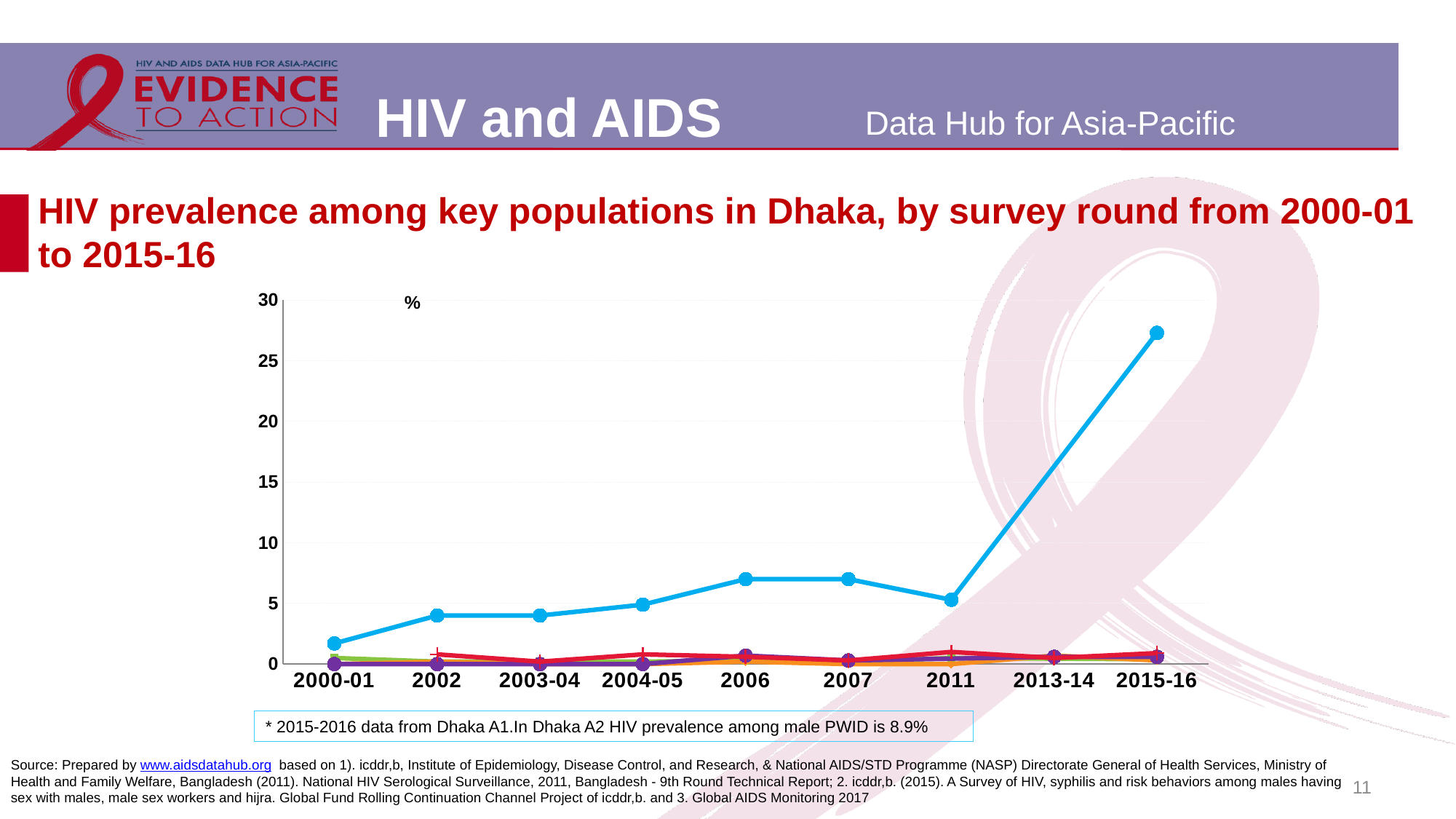
Is the highest value plotted for 2006 greater or less than 5? greater Does the top line rise or fall between 2011 and 2015-16? rises Which survey round has the larger top plotted value, 2002 or 2006? 2006 What kind of chart is shown on the slide? line chart Is the highest value plotted for 2011 greater or less than 10? less Is the highest value plotted for 2015-16 greater or less than 25? greater Which survey round has the highest plotted value on the chart? 2015-16 What unit is shown on the y axis of the chart? % How many survey rounds are shown on the x axis? 9 What is the first survey round shown on the x axis? 2000-01